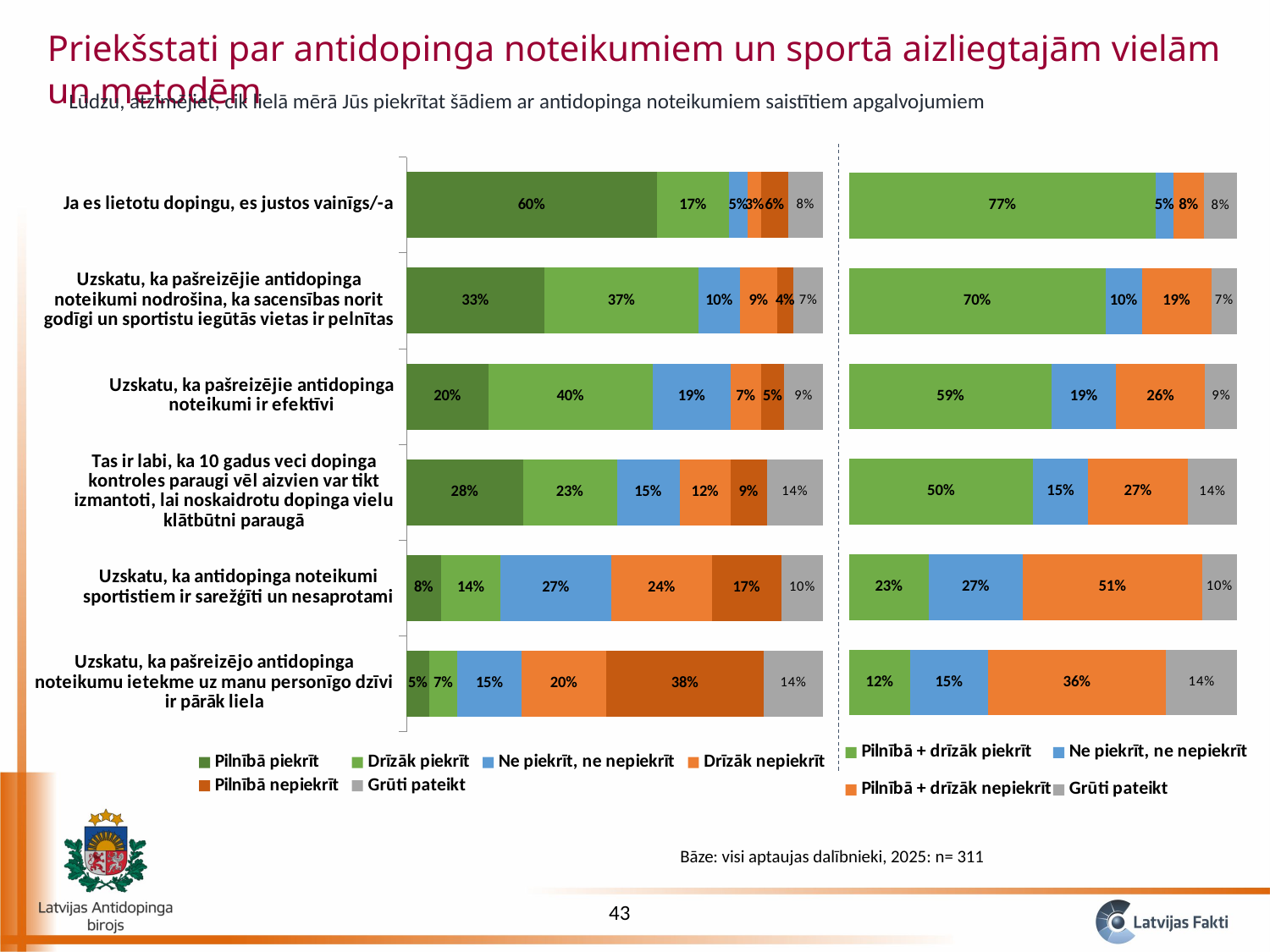
On the right chart, what is the "Pilnībā + drīzāk piekrīt" value for "Ja es lietotu dopingu, es justos vainīgs/-a"? 77% What type of chart is the right chart? Stacked bar chart On the left chart, which statement has the larger "Drīzāk piekrīt" share: "Uzskatu, ka pašreizējie antidopinga noteikumi ir efektīvi" or "Uzskatu, ka antidopinga noteikumi sportistiem ir sarežģīti un nesaprotami"? Uzskatu, ka pašreizējie antidopinga noteikumi ir efektīvi On the right chart, what is the "Pilnībā + drīzāk nepiekrīt" value for "Uzskatu, ka antidopinga noteikumi sportistiem ir sarežģīti un nesaprotami"? 51% How many statements (categories) are shown on the left chart? 6 On the left chart, what is the "Ne piekrīt, ne nepiekrīt" value for "Uzskatu, ka antidopinga noteikumi sportistiem ir sarežģīti un nesaprotami"? 27% On the left chart, what percentage answered "Pilnībā nepiekrīt" to "Uzskatu, ka pašreizējo antidopinga noteikumu ietekme uz manu personīgo dzīvi ir pārāk liela"? 38% On the left chart, what percentage of respondents answered "Pilnībā piekrīt" to "Ja es lietotu dopingu, es justos vainīgs/-a"? 60% On the right chart, which statement has the highest "Pilnībā + drīzāk piekrīt" value? Ja es lietotu dopingu, es justos vainīgs/-a On the right chart, which statement has the lowest "Pilnībā + drīzāk piekrīt" value? Uzskatu, ka pašreizējo antidopinga noteikumu ietekme uz manu personīgo dzīvi ir pārāk liela How many series does the legend of the left chart list? 6 On the right chart, what is the difference in "Pilnībā + drīzāk piekrīt" between "Ja es lietotu dopingu, es justos vainīgs/-a" and "Uzskatu, ka pašreizējie antidopinga noteikumi nodrošina, ka sacensības norit godīgi un sportistu iegūtās vietas ir pelnītas"? 7 percentage points